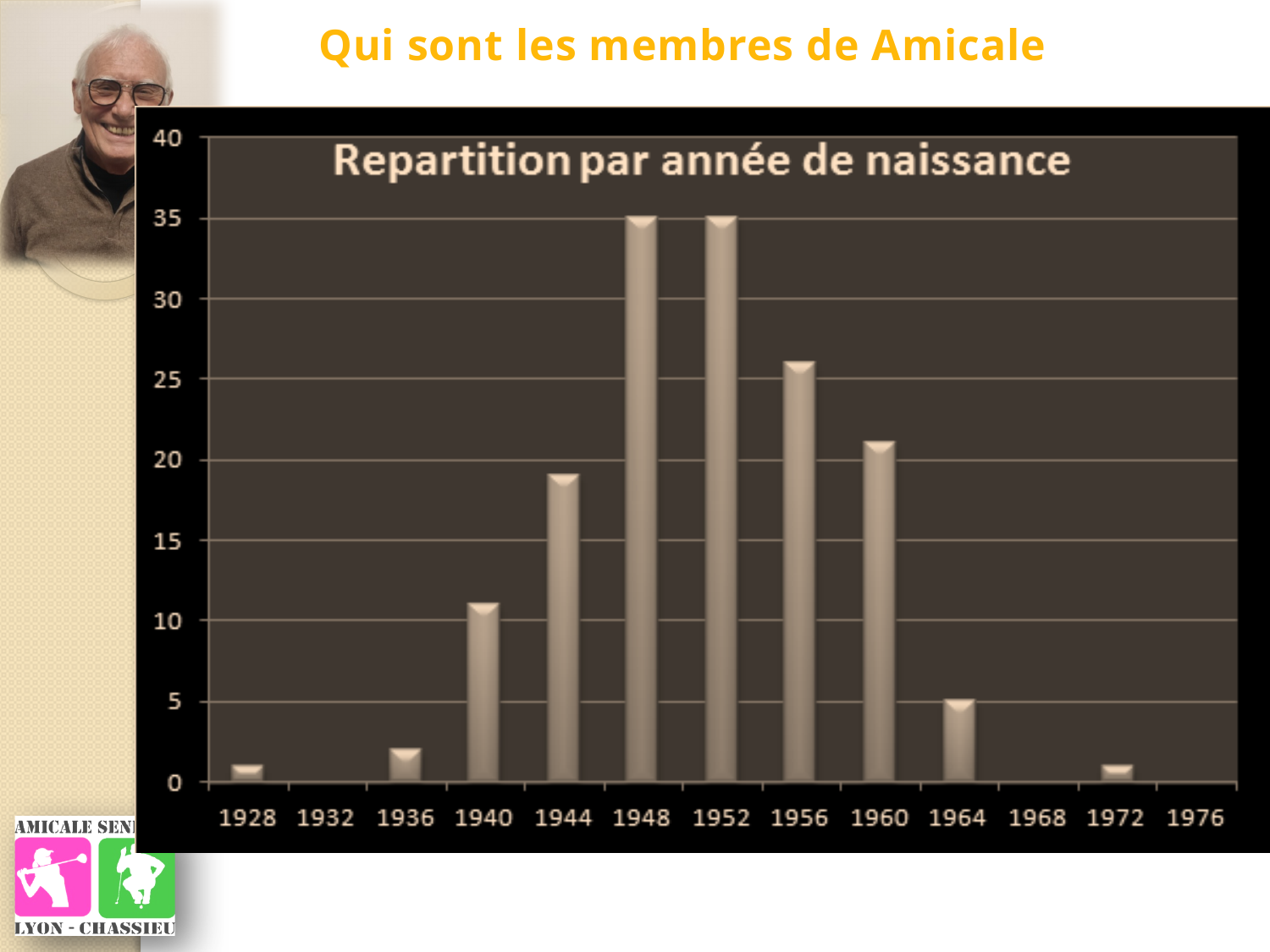
Is the value for 1944 greater or less than 20? less What kind of chart is shown on the slide? Bar chart Is the value for 1956 greater or less than 25? greater Is the value for 1940 greater or less than 10? greater What is the value for 1948? 35 What is the value for 1964? 5 What is the title of the chart? Repartition par année de naissance Which has the larger value, 1944 or 1956? 1956 Do the values rise or fall from 1952 to 1964? fall What is the value for 1952? 35 How many years are labelled on the x axis of the chart? 13